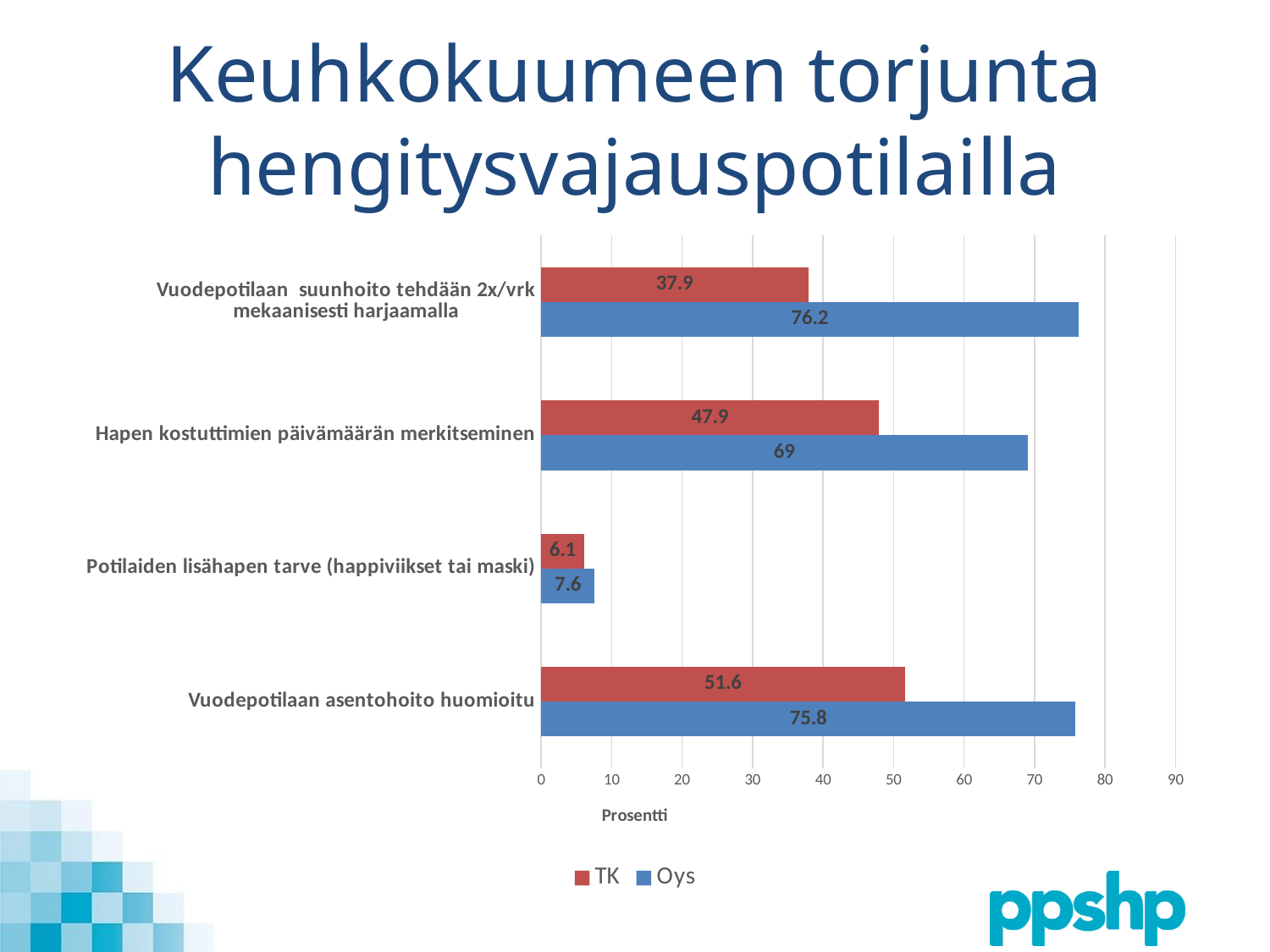
What is the Oys value for "Vuodepotilaan asentohoito huomioitu"? 75.8 What is the label of the horizontal axis? Prosentti What is the TK value for "Hapen kostuttimien päivämäärän merkitseminen"? 47.9 Which category has the highest TK value? Vuodepotilaan asentohoito huomioitu What is the Oys value for "Vuodepotilaan suunhoito tehdään 2x/vrk mekaanisesti harjaamalla"? 76.2 How many series does the legend list? 2 Which is larger for "Hapen kostuttimien päivämäärän merkitseminen": the TK value or the Oys value? Oys What kind of chart is shown on the slide? Bar chart Which category has the lowest Oys value? Potilaiden lisähapen tarve (happiviikset tai maski) How many categories are shown on the chart? 4 What is the TK value for "Potilaiden lisähapen tarve (happiviikset tai maski)"? 6.1 What is the difference between the Oys and TK values for "Vuodepotilaan suunhoito tehdään 2x/vrk mekaanisesti harjaamalla"? 38.3